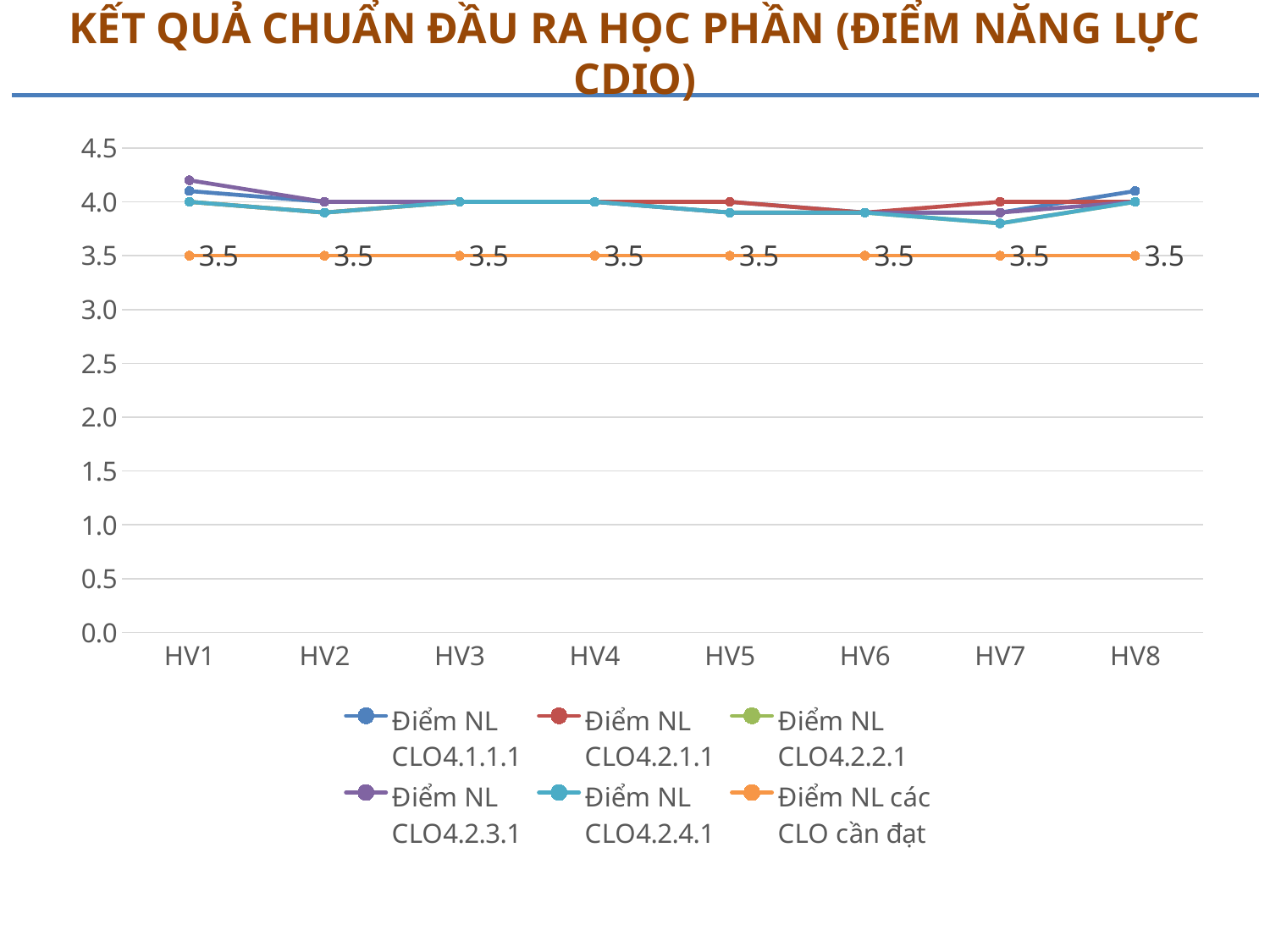
How many series does the legend list? 6 What is the value of "Điểm NL các CLO cần đạt" at HV1? 3.5 At HV1, which is larger: "Điểm NL CLO4.2.3.1" or "Điểm NL các CLO cần đạt"? Điểm NL CLO4.2.3.1 Is the value for "Điểm NL CLO4.2.4.1" at HV7 greater or less than 4.0? less Is the value for "Điểm NL CLO4.2.3.1" at HV1 greater or less than 4.0? greater What is the title of the slide? KẾT QUẢ CHUẨN ĐẦU RA HỌC PHẦN (ĐIỂM NĂNG LỰC CDIO) How many categories (HV1 to HV8) are plotted on the x axis? 8 Does the "Điểm NL các CLO cần đạt" series rise, fall, or stay flat from HV1 to HV8? stays flat What is the value of "Điểm NL các CLO cần đạt" at HV8? 3.5 What kind of chart is shown on the slide? line chart What colour is the line for "Điểm NL các CLO cần đạt"? orange Is the value for "Điểm NL các CLO cần đạt" at HV5 greater or less than 4.0? less